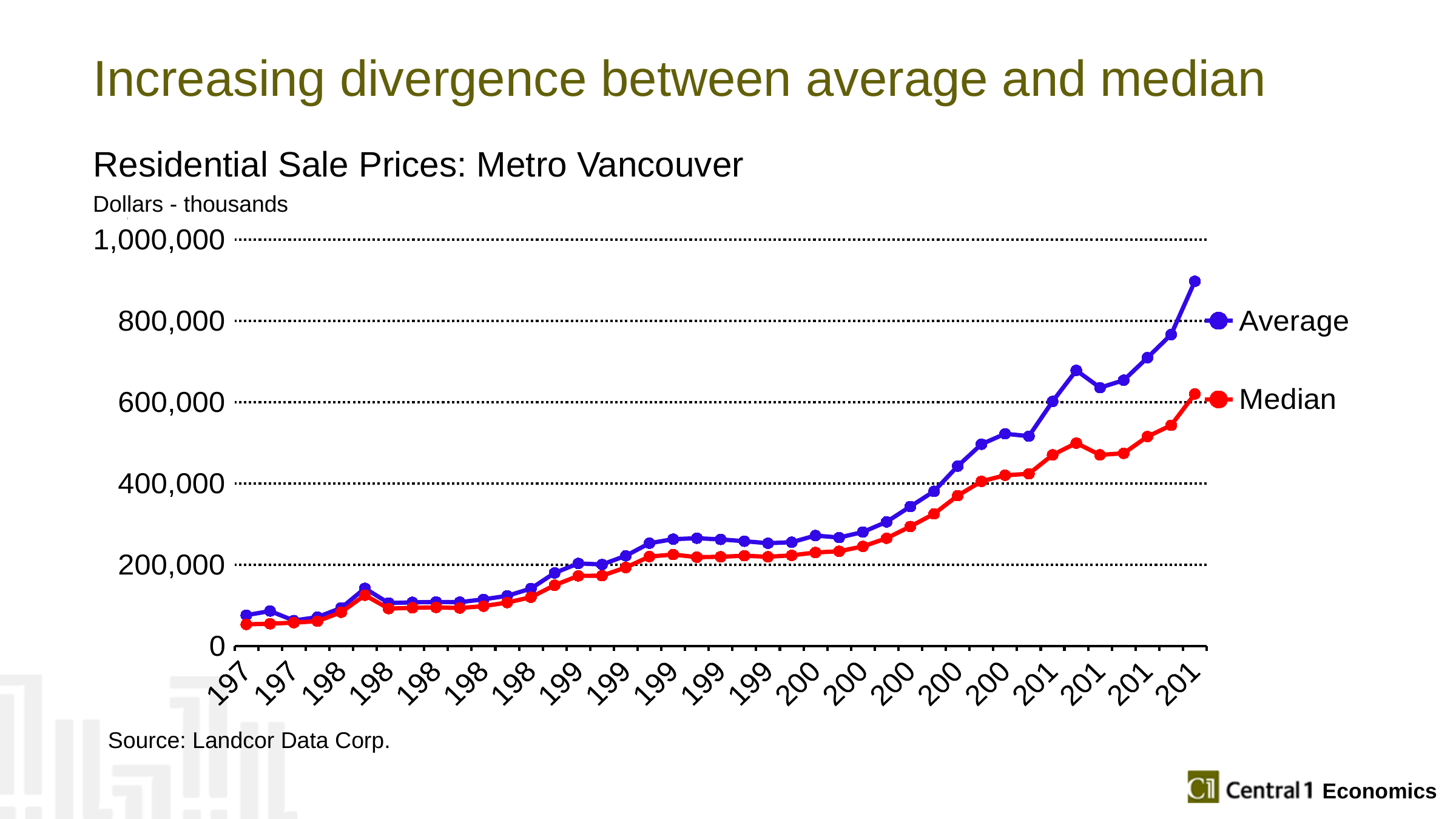
What are the two series named in the legend? Average and Median Is the final value of the Median series greater or less than 800,000? less Is the final value of the Average series greater or less than 800,000? greater Which series reaches the highest value on the chart? Average How many series does the legend list? 2 Is the final value of the Median series greater or less than 400,000? greater At the right end of the chart, which series is higher, Average or Median? Average What is the highest value shown on the y axis? 1,000,000 Do the values of the Average series generally rise or fall from left to right along the x axis? rise What is the title of the chart? Residential Sale Prices: Metro Vancouver What kind of chart is shown on the slide? line chart